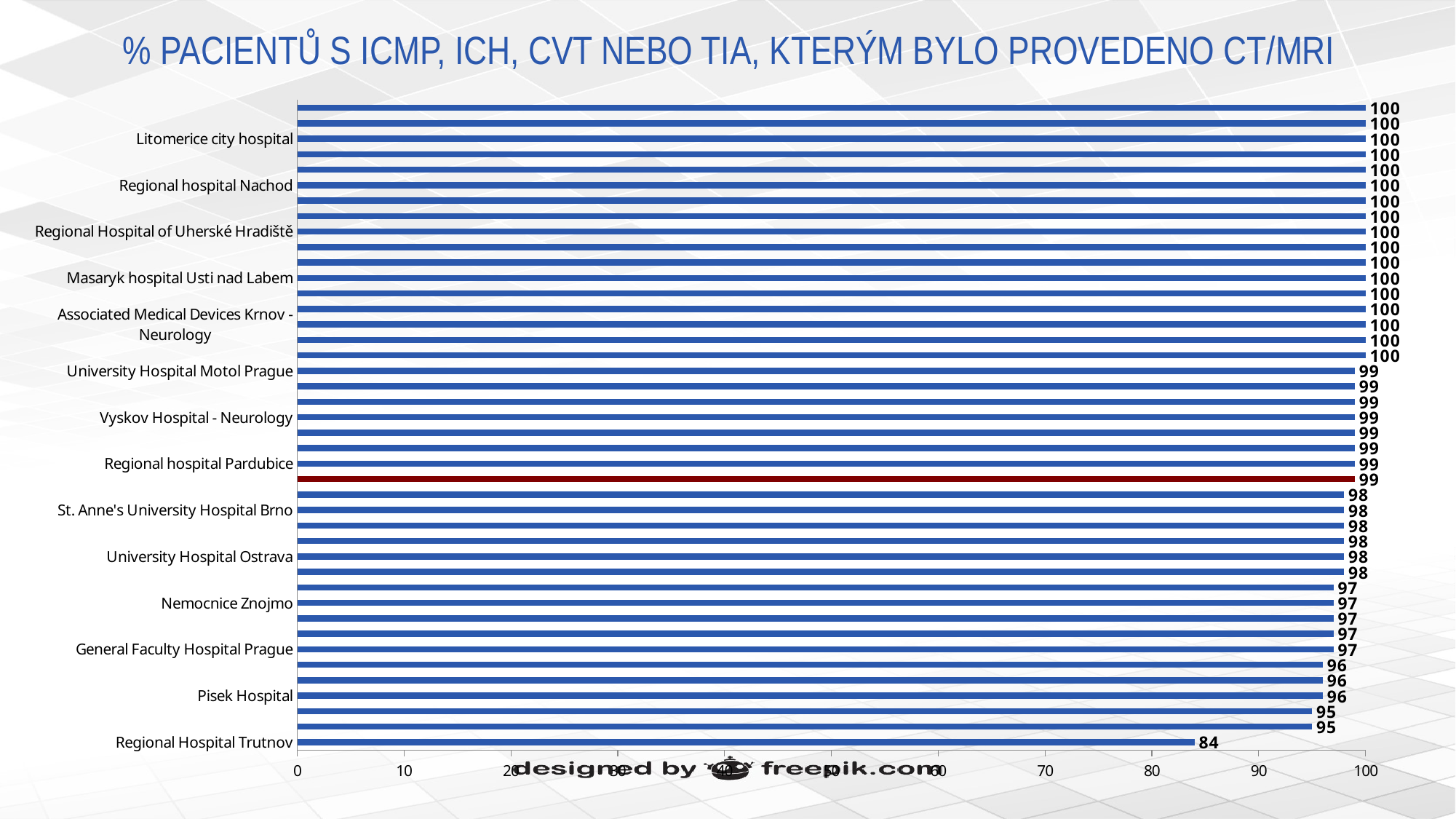
What is the value for Regional Hospital Trutnov? 84 What is the value for Nemocnice Znojmo? 97 What is the value for University Hospital Ostrava? 98 Is the value for Regional Hospital Trutnov greater or less than 90? less What value is labelled on the single red bar in the chart? 99 What is the value for Pisek Hospital? 96 What is the value for Litomerice city hospital? 100 What is the difference between the values for Pisek Hospital and Regional Hospital Trutnov? 12 Which hospital has the lowest value? Regional Hospital Trutnov What is the value for Regional hospital Pardubice? 99 What kind of chart is shown on the slide? bar chart Which is larger, the value for Masaryk hospital Usti nad Labem or the value for Regional Hospital Trutnov? Masaryk hospital Usti nad Labem